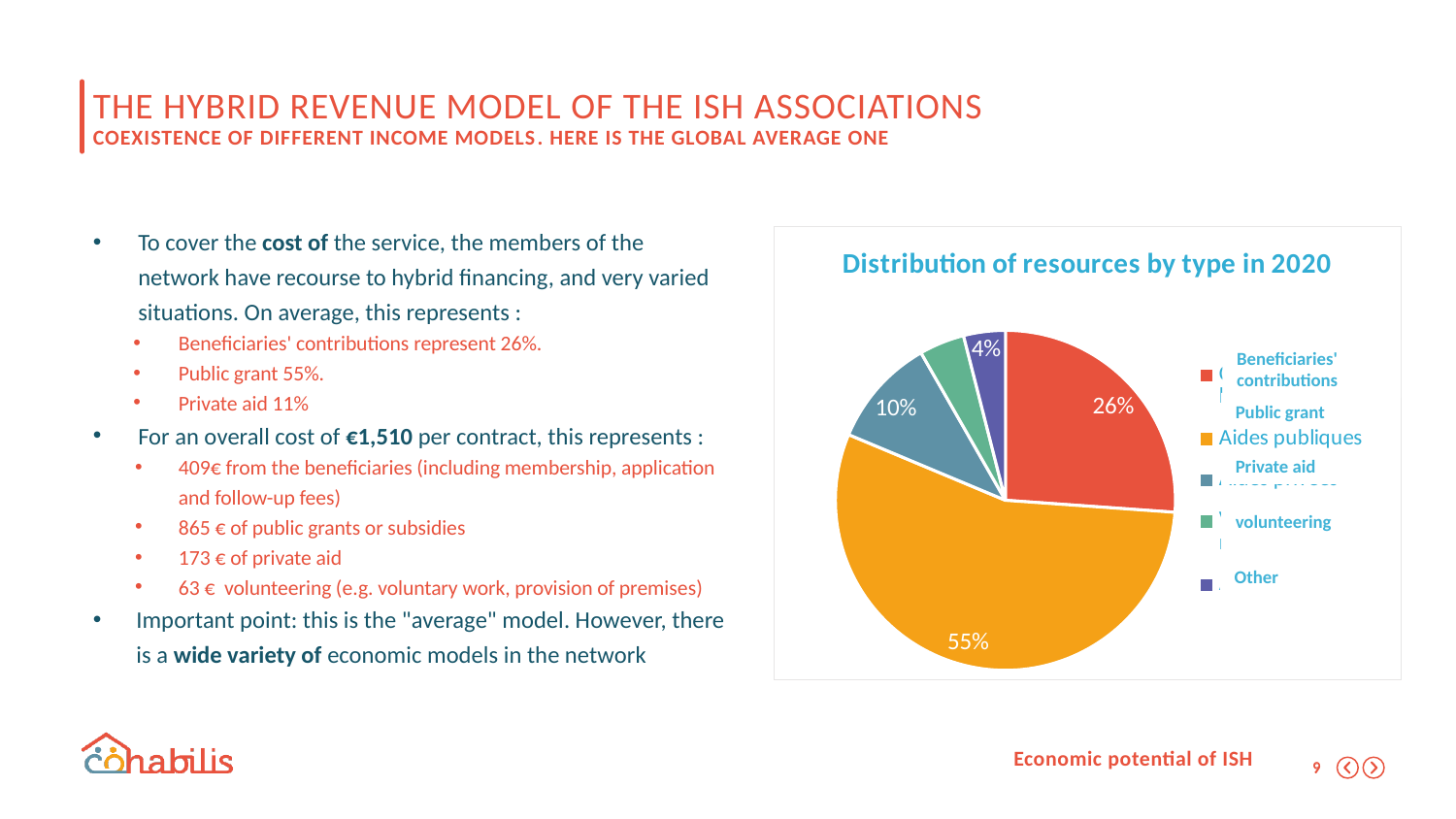
Which resource type has the largest share of the pie? Public grant What percentage of the pie is Private aid? 10% How many percentage points larger is the Public grant share than the Beneficiaries' contributions share? 29 percentage points How many percentage points larger is the Beneficiaries' contributions share than the Private aid share? 16 percentage points What colour is the Public grant slice of the pie? Orange What kind of chart is shown on the slide? Pie chart How many slices does the pie chart have? 5 What percentage of the pie is labelled Other? 4% Which is larger: Beneficiaries' contributions or Private aid? Beneficiaries' contributions What is the title of the chart? Distribution of resources by type in 2020 What percentage of the pie is Beneficiaries' contributions? 26% What share of resources comes from public grants according to the pie chart? 55%